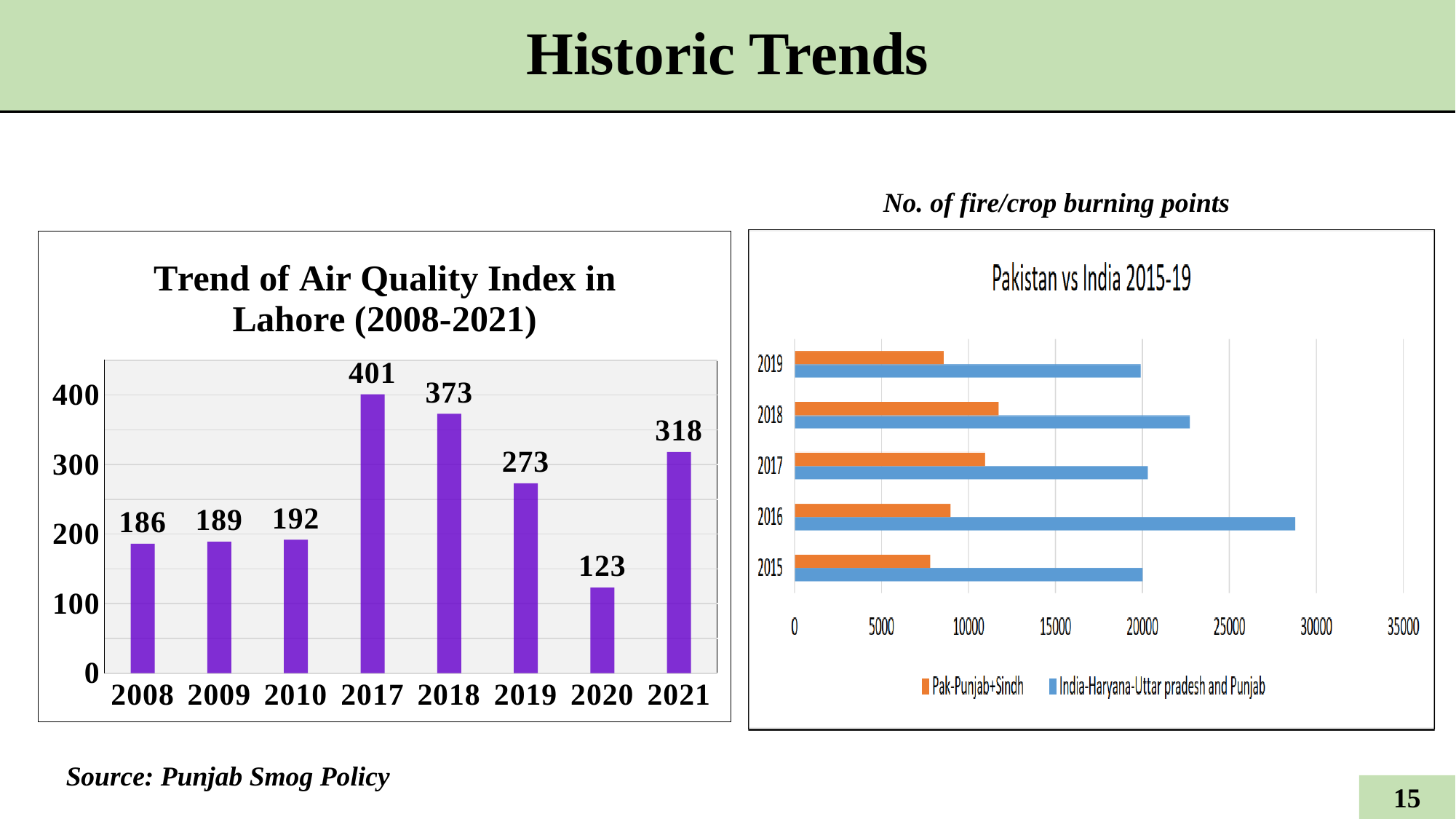
What kind of chart is the 'Trend of Air Quality Index in Lahore (2008-2021)' chart? bar chart In the 'Trend of Air Quality Index in Lahore (2008-2021)' chart, what is the value for 2017? 401 In the 'Trend of Air Quality Index in Lahore (2008-2021)' chart, which year has the highest value? 2017 In the 'Trend of Air Quality Index in Lahore (2008-2021)' chart, what is the value for 2020? 123 In the 'Trend of Air Quality Index in Lahore (2008-2021)' chart, what is the difference between the values for 2018 and 2019? 100 In the 'Trend of Air Quality Index in Lahore (2008-2021)' chart, which year has the lowest value? 2020 In the 'Pakistan vs India 2015-19' chart, which colour represents Pak-Punjab+Sindh? orange In the 'Trend of Air Quality Index in Lahore (2008-2021)' chart, which is larger, the value for 2021 or the value for 2019? 2021 In the 'Pakistan vs India 2015-19' chart, which year has the highest value for India-Haryana-Uttar pradesh and Punjab? 2016 In the 'Pakistan vs India 2015-19' chart, is the value for India-Haryana-Uttar pradesh and Punjab in 2016 greater or less than 25000? greater In the 'Pakistan vs India 2015-19' chart, how many series does the legend list? 2 How many years are shown on the x axis of the 'Trend of Air Quality Index in Lahore (2008-2021)' chart? 8